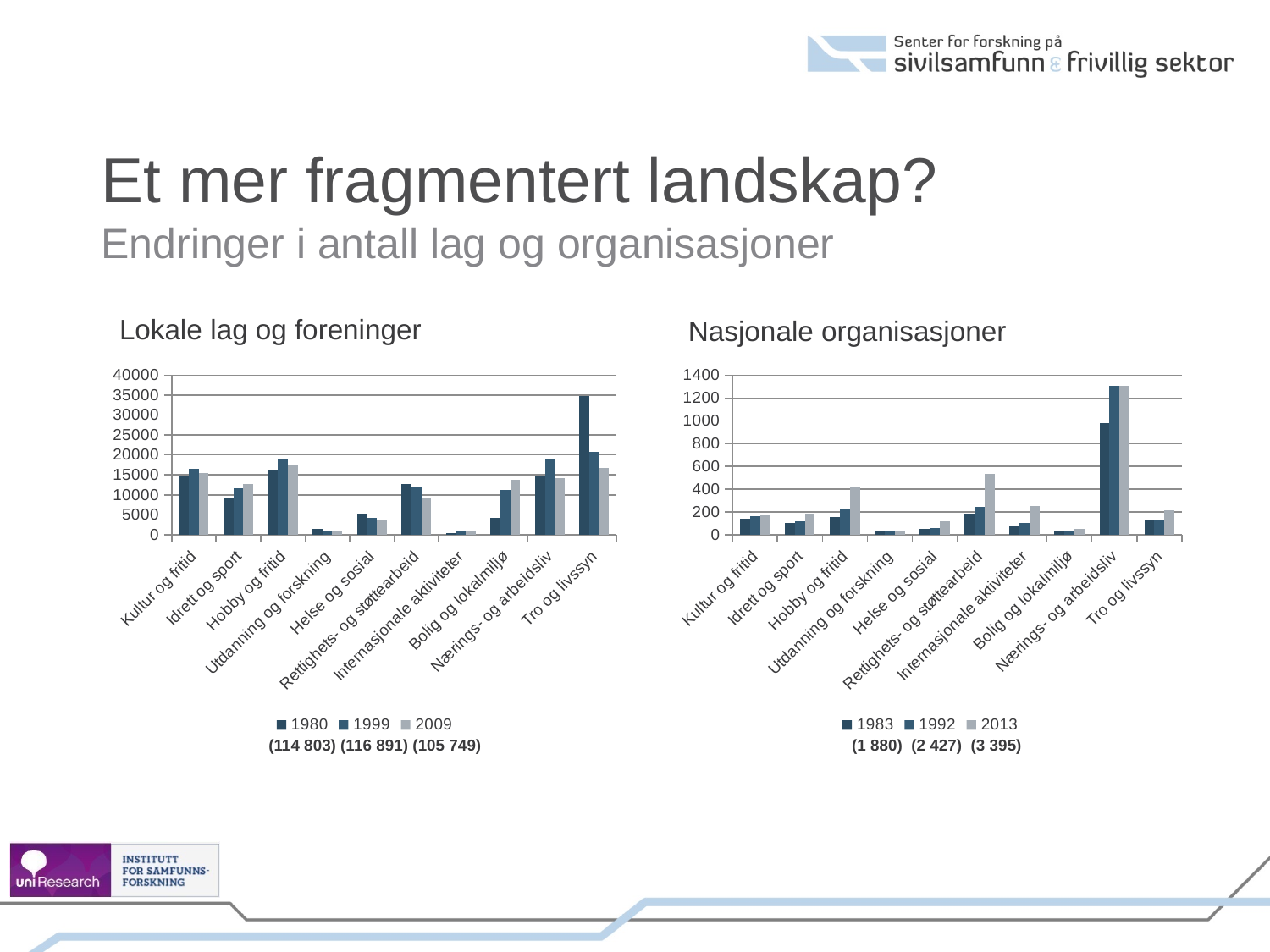
In the 'Lokale lag og foreninger' chart, is the 1999 value for Hobby og fritid greater or less than 15000? greater In the 'Lokale lag og foreninger' chart, do the values for Tro og livssyn rise or fall from 1980 to 2009? fall In the 'Nasjonale organisasjoner' chart, is the 2013 value for Nærings- og arbeidsliv greater or less than 1200? greater In the 'Nasjonale organisasjoner' chart, is the 1983 value for Kultur og fritid greater or less than 200? less How many series does the legend of the 'Nasjonale organisasjoner' chart list? 3 In the 'Nasjonale organisasjoner' chart, which is larger for 2013: Rettighets- og støttearbeid or Internasjonale aktiviteter? Rettighets- og støttearbeid What type of chart is the 'Lokale lag og foreninger' chart? bar chart In the 'Nasjonale organisasjoner' chart, which category has the tallest bars? Nærings- og arbeidsliv In the 'Lokale lag og foreninger' chart, which category has the tallest bar? Tro og livssyn What are the three series listed in the legend of the 'Lokale lag og foreninger' chart? 1980, 1999, 2009 How many categories are shown on the x axis of the 'Lokale lag og foreninger' chart? 10